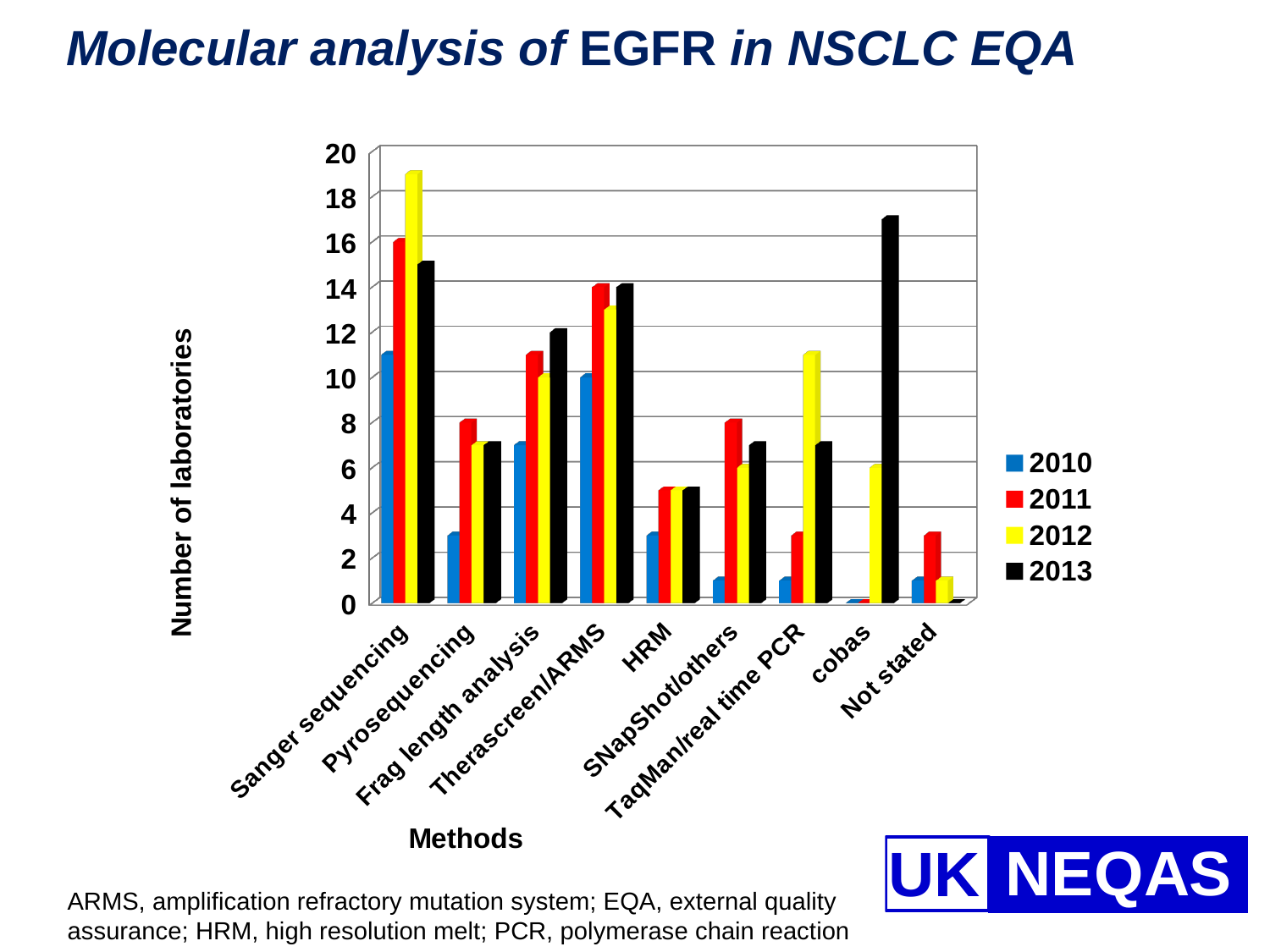
Is the value for Sanger sequencing in 2012 greater or less than 18? greater How many series does the legend list? 4 What is the number of laboratories for Frag length analysis in 2013? 12 What is the number of laboratories for Sanger sequencing in 2011? 16 What is the label of the vertical axis? Number of laboratories Is the value for cobas in 2013 greater or less than 16? greater What is the number of laboratories for Therascreen/ARMS in 2010? 10 What kind of chart is shown on the slide? bar chart Which method has the highest number of laboratories in 2013? cobas Which is larger in 2013: the value for cobas or the value for Sanger sequencing? cobas Which method has the highest number of laboratories in 2012? Sanger sequencing How many methods are shown along the x axis? 9